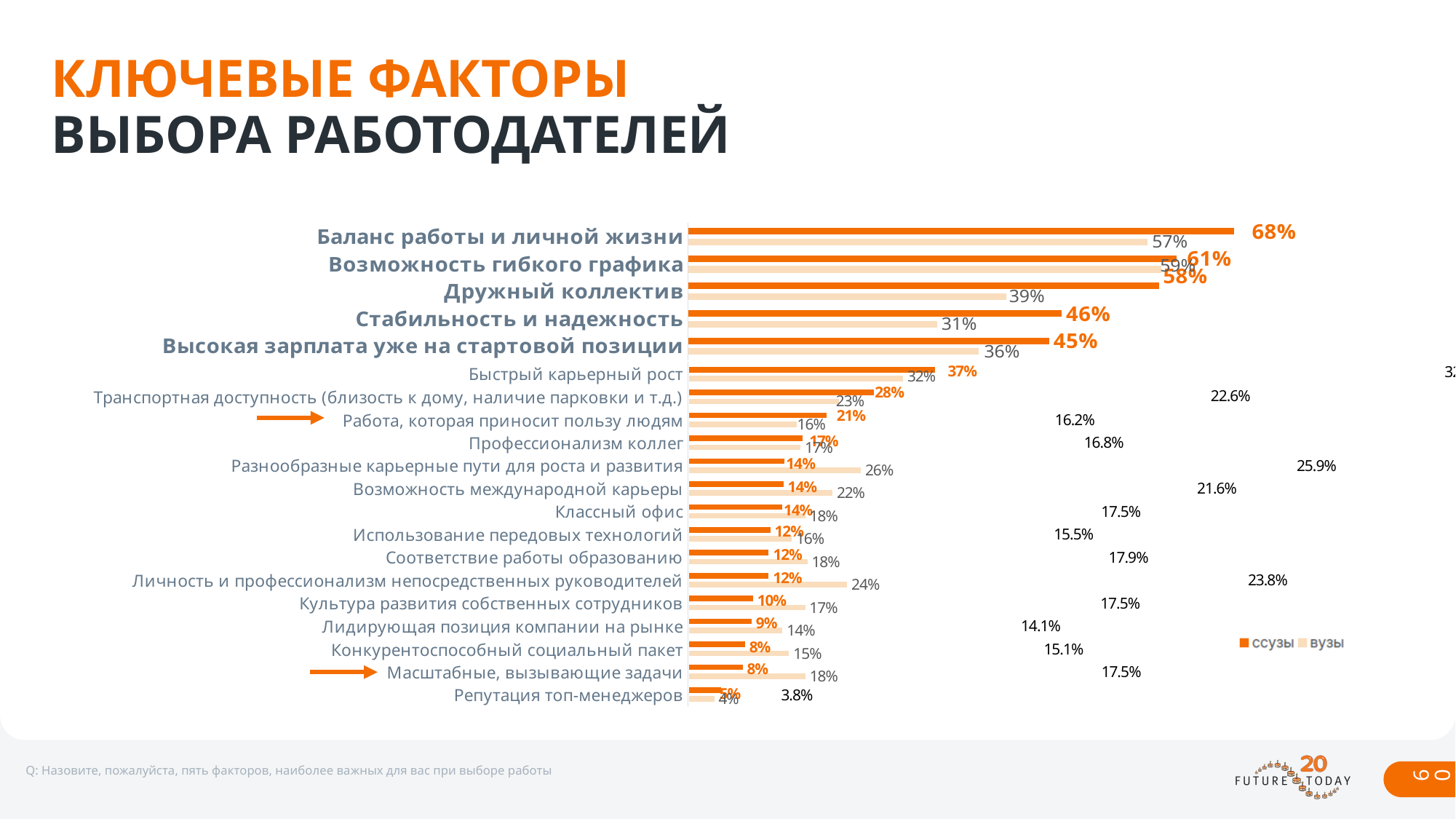
What is the value for вузы for 'Дружный коллектив'? 39% What is the value for вузы for 'Личность и профессионализм непосредственных руководителей'? 24% Which category has the highest value for ссузы? Баланс работы и личной жизни What is the difference between the ссузы and вузы values for 'Стабильность и надежность'? 15% How many series does the legend list? 2 Which series is shown in dark orange in the legend? ссузы What is the value for ссузы for 'Быстрый карьерный рост'? 37% Which category has the lowest value for вузы? Репутация топ-менеджеров How many categories (factors) are plotted in the chart? 20 What kind of chart is shown on the slide? bar chart For 'Разнообразные карьерные пути для роста и развития', which series has the larger value, ссузы or вузы? вузы What is the value for ссузы for 'Баланс работы и личной жизни'? 68%